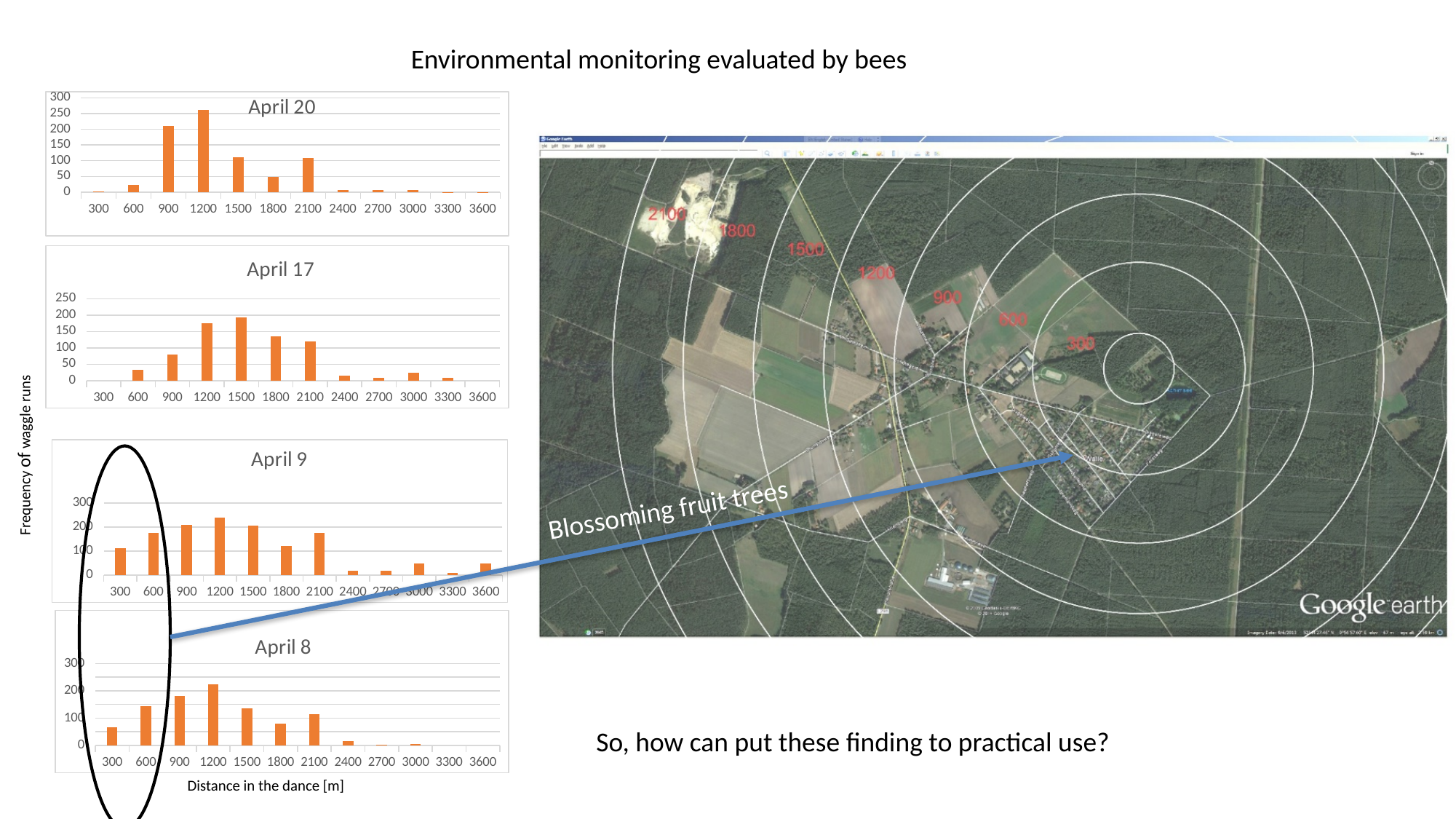
In the April 20 chart, which distance has the highest frequency of waggle runs? 1200 In the April 20 chart, which is larger, the value for 900 or the value for 600? 900 In the April 9 chart, is the value for 600 greater or less than 100? greater In the April 8 chart, which distance has the highest frequency of waggle runs? 1200 In the April 17 chart, which distance has the highest frequency of waggle runs? 1500 What kind of chart is the April 20 chart? bar chart How many distance categories are shown on the x axis of the April 8 chart? 12 In the April 20 chart, is the value for 900 greater or less than 150? greater What is the label of the shared x axis below the April 8 chart? Distance in the dance [m] In the April 8 chart, is the value for 300 greater or less than 100? less